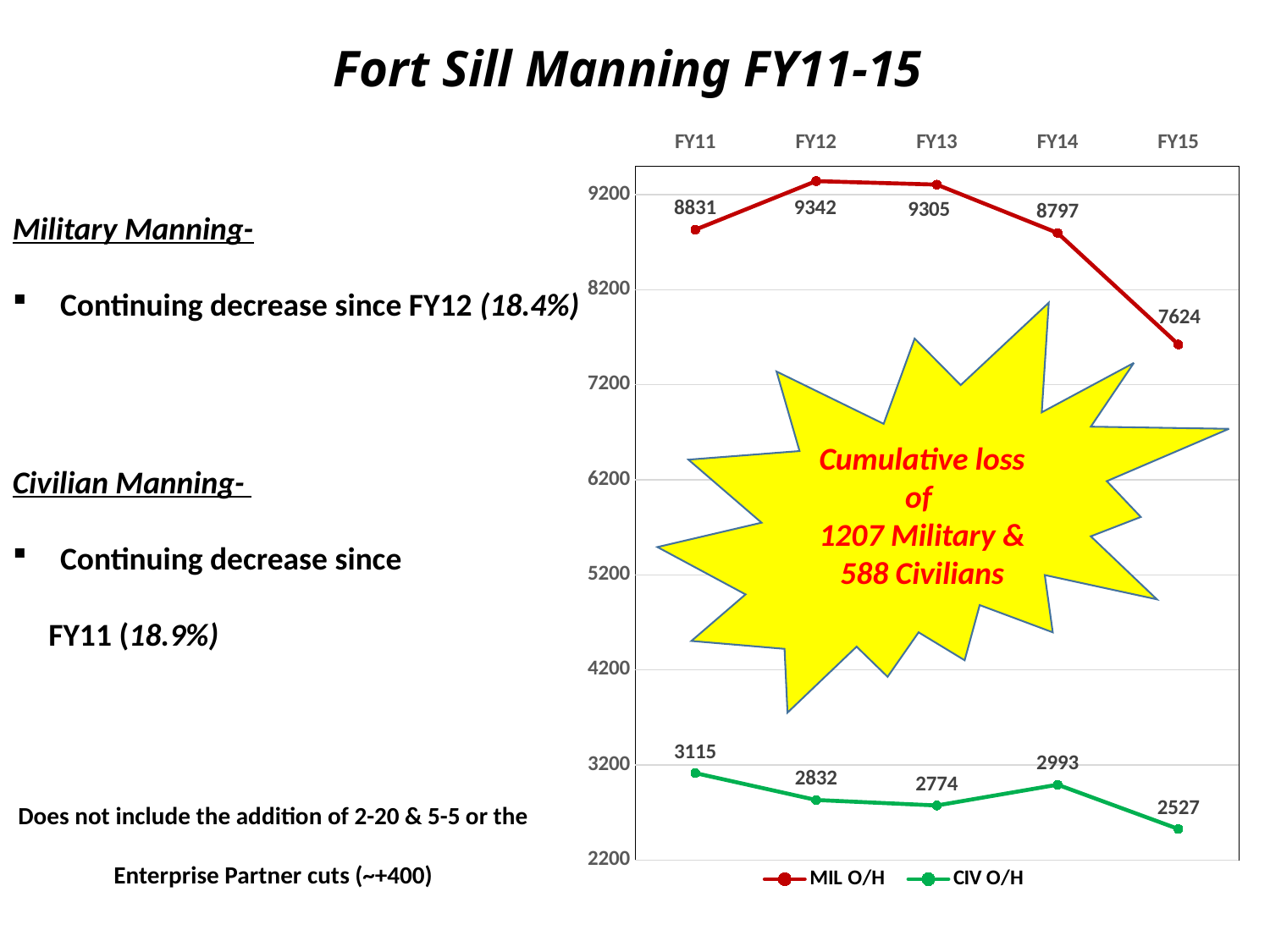
How many fiscal years are plotted on the x axis? 5 What is the CIV O/H value for FY15? 2527 What kind of chart is shown on the slide? line chart What is the MIL O/H value for FY15? 7624 How many series does the legend list? 2 What is the MIL O/H value for FY12? 9342 What is the difference between CIV O/H in FY11 and FY15? 588 Does MIL O/H rise or fall from FY12 to FY15? fall Which is larger, CIV O/H in FY12 or CIV O/H in FY14? FY14 In which fiscal year is CIV O/H lowest? FY15 In which fiscal year is MIL O/H highest? FY12 What is the difference between MIL O/H in FY12 and FY15? 1718